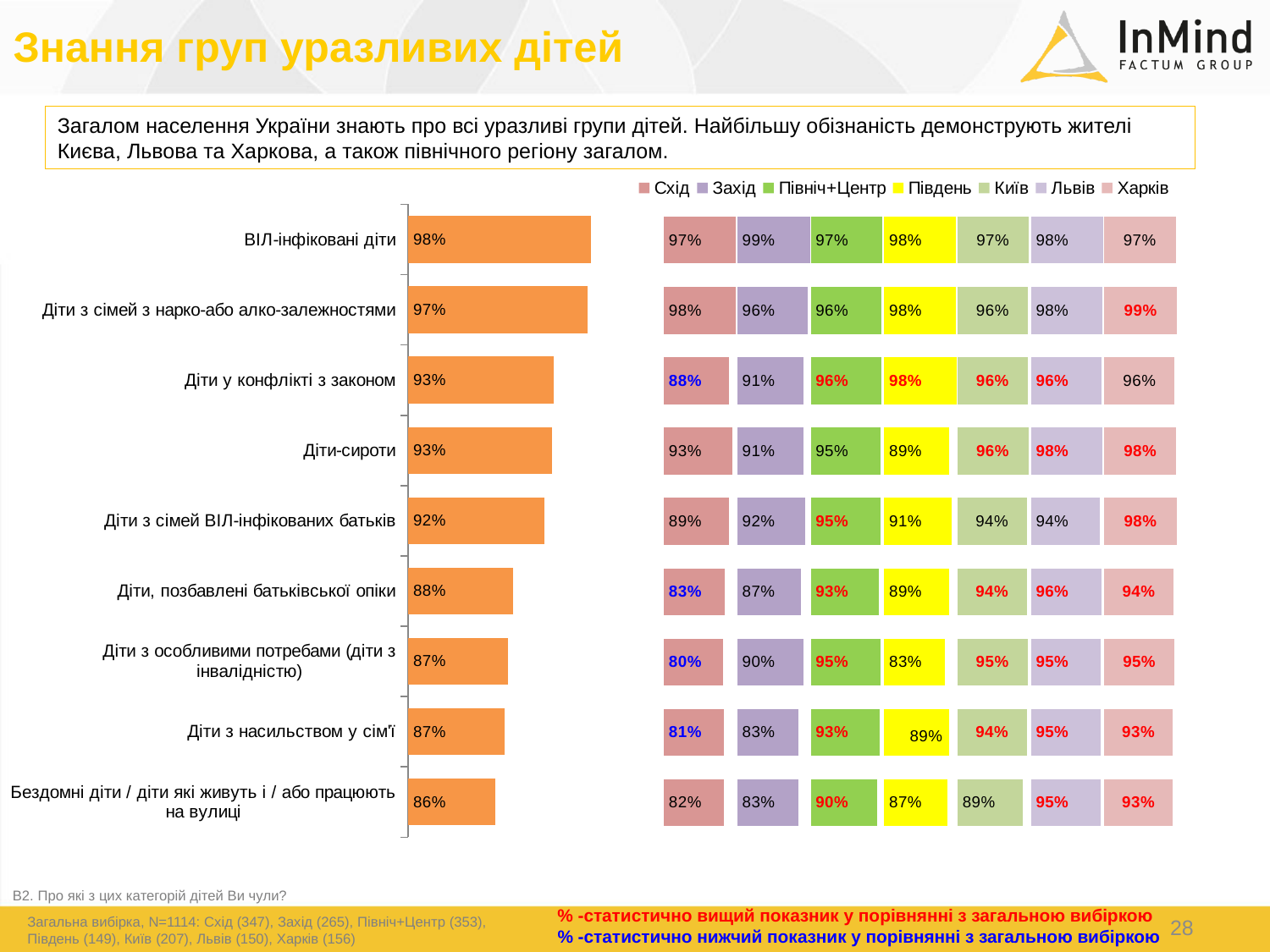
How many categories are shown on the left bar chart? 9 On the left bar chart, which category has the highest value? ВІЛ-інфіковані діти On the right regional chart, what is the value for Харків for Діти з сімей з нарко-або алко-залежностями? 99% On the left bar chart, which is larger: the value for Діти з сімей ВІЛ-інфікованих батьків or the value for Діти з особливими потребами (діти з інвалідністю)? Діти з сімей ВІЛ-інфікованих батьків On the right regional chart, what is the value for Схід for Діти у конфлікті з законом? 88% What type of chart is the chart on the left of the slide? Bar chart On the left bar chart, which category has the lowest value? Бездомні діти / діти які живуть і / або працюють на вулиці How many series does the legend of the right regional chart list? 7 On the left bar chart, what is the value for ВІЛ-інфіковані діти? 98% On the left bar chart, what is the value for Бездомні діти / діти які живуть і / або працюють на вулиці? 86% On the right regional chart, what is the difference between the Південь and Схід values for Діти з особливими потребами (діти з інвалідністю)? 3% On the left bar chart, what is the difference between the values for ВІЛ-інфіковані діти and Діти, позбавлені батьківської опіки? 10%